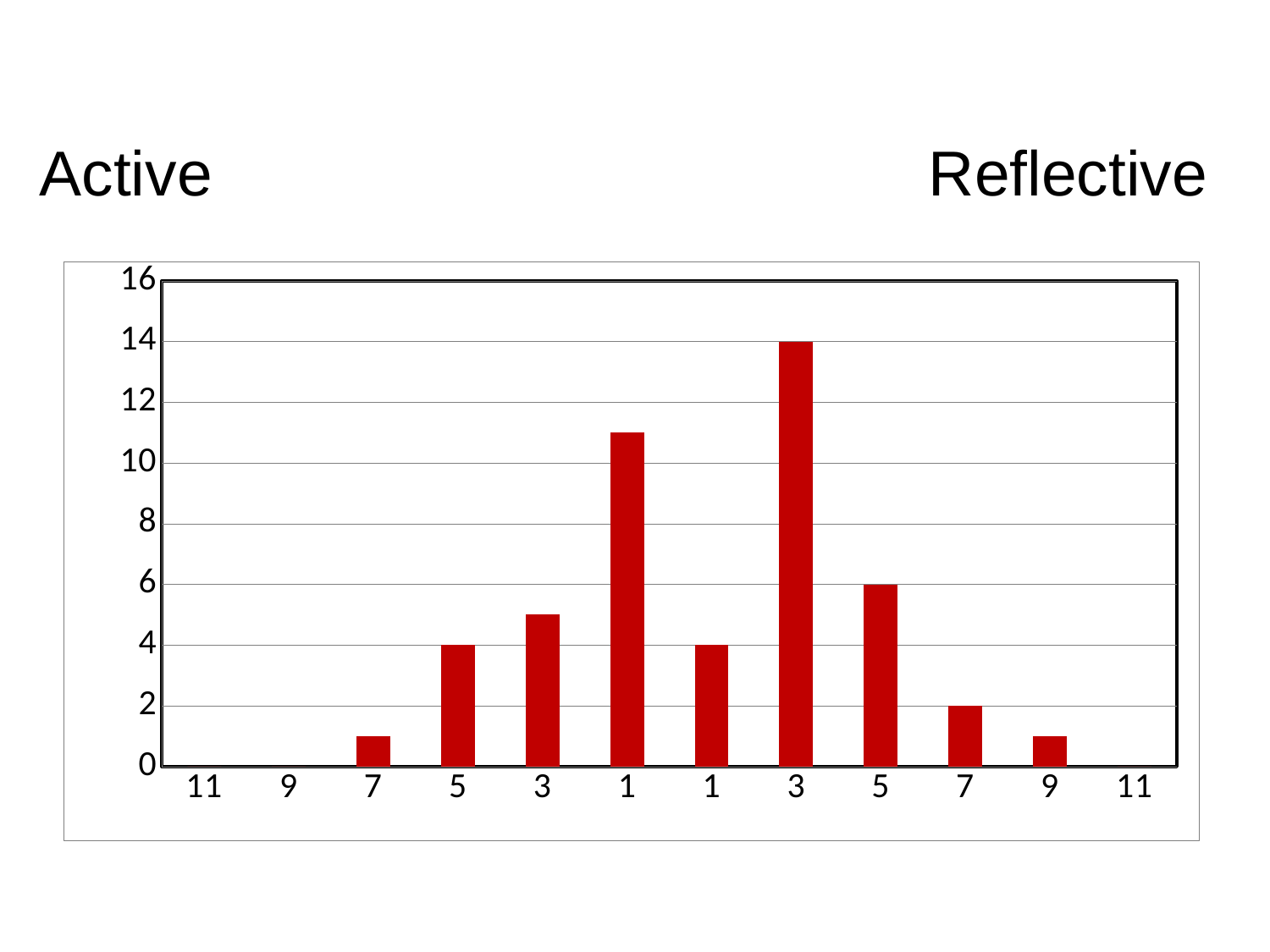
What is the value of the bar at 5 on the Active side? 4 What colour are the bars in the chart? red Which category has the tallest bar? 3 on the Reflective side What kind of chart is shown on the slide? bar chart What is the value of the bar at 3 on the Reflective side? 14 What is the value of the bar at 7 on the Reflective side? 2 What is the difference between the bar at 3 on the Reflective side and the bar at 5 on the Reflective side? 8 Is the value of the bar at 3 on the Active side greater or less than 6? less Which is larger: the bar at 1 on the Active side or the bar at 3 on the Reflective side? 3 on the Reflective side Is the value of the bar at 1 on the Active side greater or less than 10? greater How many categories are shown along the x axis? 12 What is the value of the bar at 5 on the Reflective side? 6